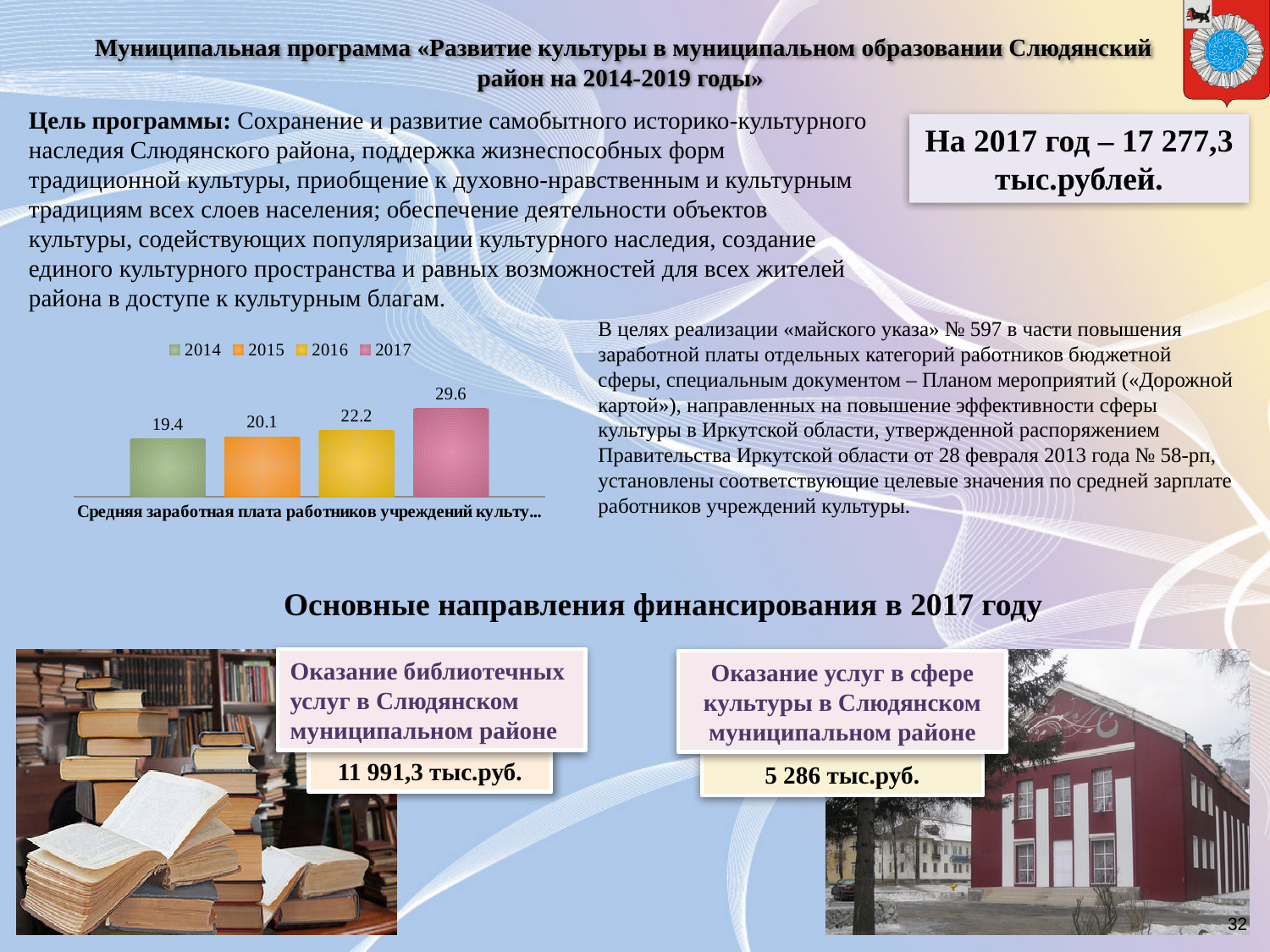
What is the value shown for 2016 in the bar chart? 22.2 What is the value shown for 2017 in the bar chart? 29.6 Which year has the highest value in the bar chart? 2017 What is the difference between the values for 2015 and 2014 in the bar chart? 0.7 Which is larger in the bar chart, the value for 2016 or the value for 2015? 2016 What is the difference between the values for 2017 and 2016 in the bar chart? 7.4 Do the values in the bar chart rise or fall from 2014 to 2017? rise What is the value shown for 2015 in the bar chart? 20.1 Which year has the lowest value in the bar chart? 2014 How many entries does the legend of the bar chart list? 4 What is the value shown for 2014 in the bar chart? 19.4 What type of chart is shown on the slide? bar chart